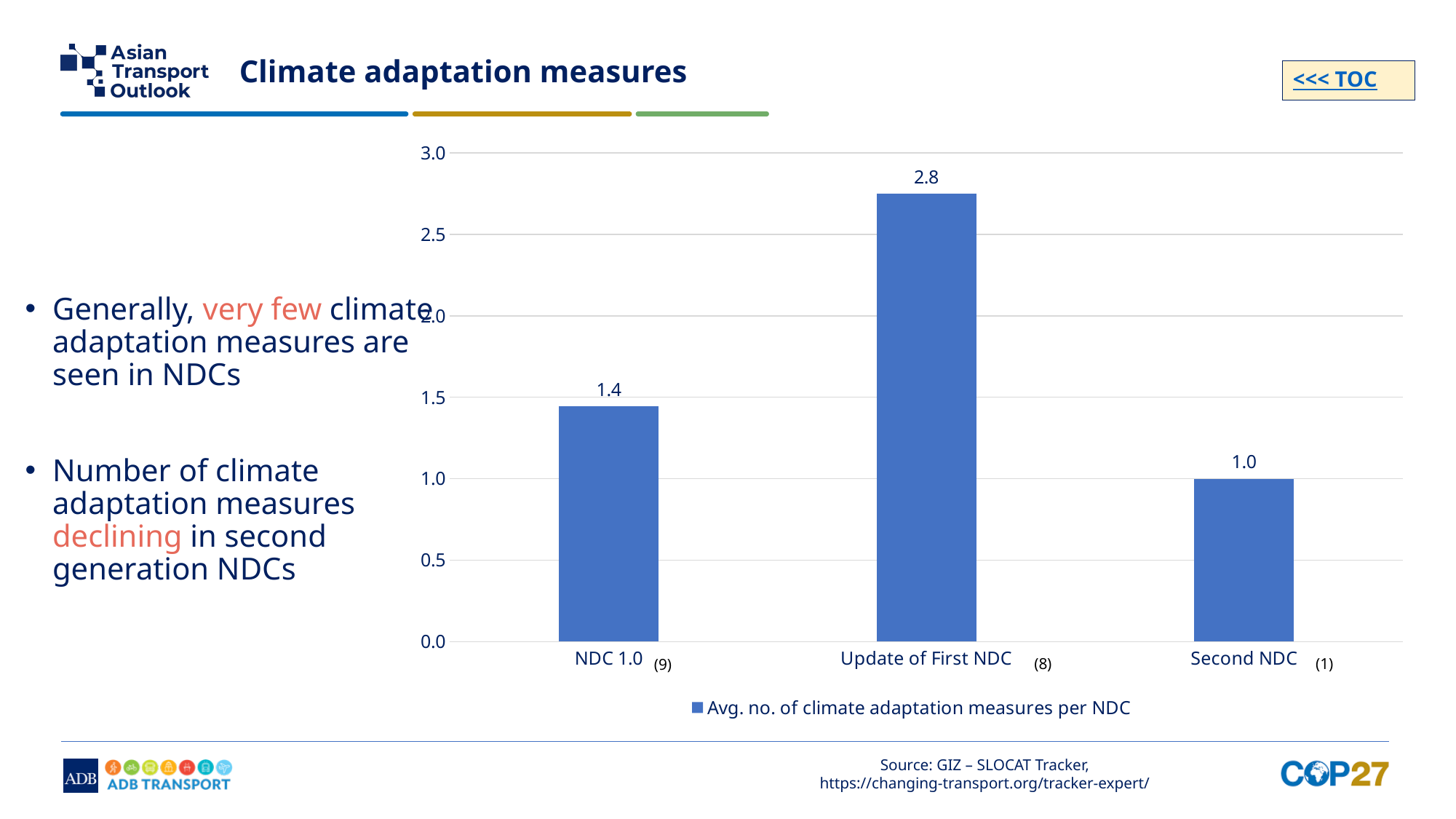
How many categories are shown on the x axis of the chart? 3 How many series does the chart legend list? 1 Which is larger, the value for NDC 1.0 or the value for Second NDC? NDC 1.0 What kind of chart is shown on the slide? Bar chart What is the legend entry for the series shown in the chart? Avg. no. of climate adaptation measures per NDC Is the value for Update of First NDC greater or less than 2.5? greater Which category has the lowest average number of climate adaptation measures per NDC? Second NDC What is the difference between the values for Update of First NDC and NDC 1.0? 1.4 What is the average number of climate adaptation measures per NDC for NDC 1.0? 1.4 Which category has the highest average number of climate adaptation measures per NDC? Update of First NDC What is the average number of climate adaptation measures per NDC for Second NDC? 1.0 What is the average number of climate adaptation measures per NDC for Update of First NDC? 2.8